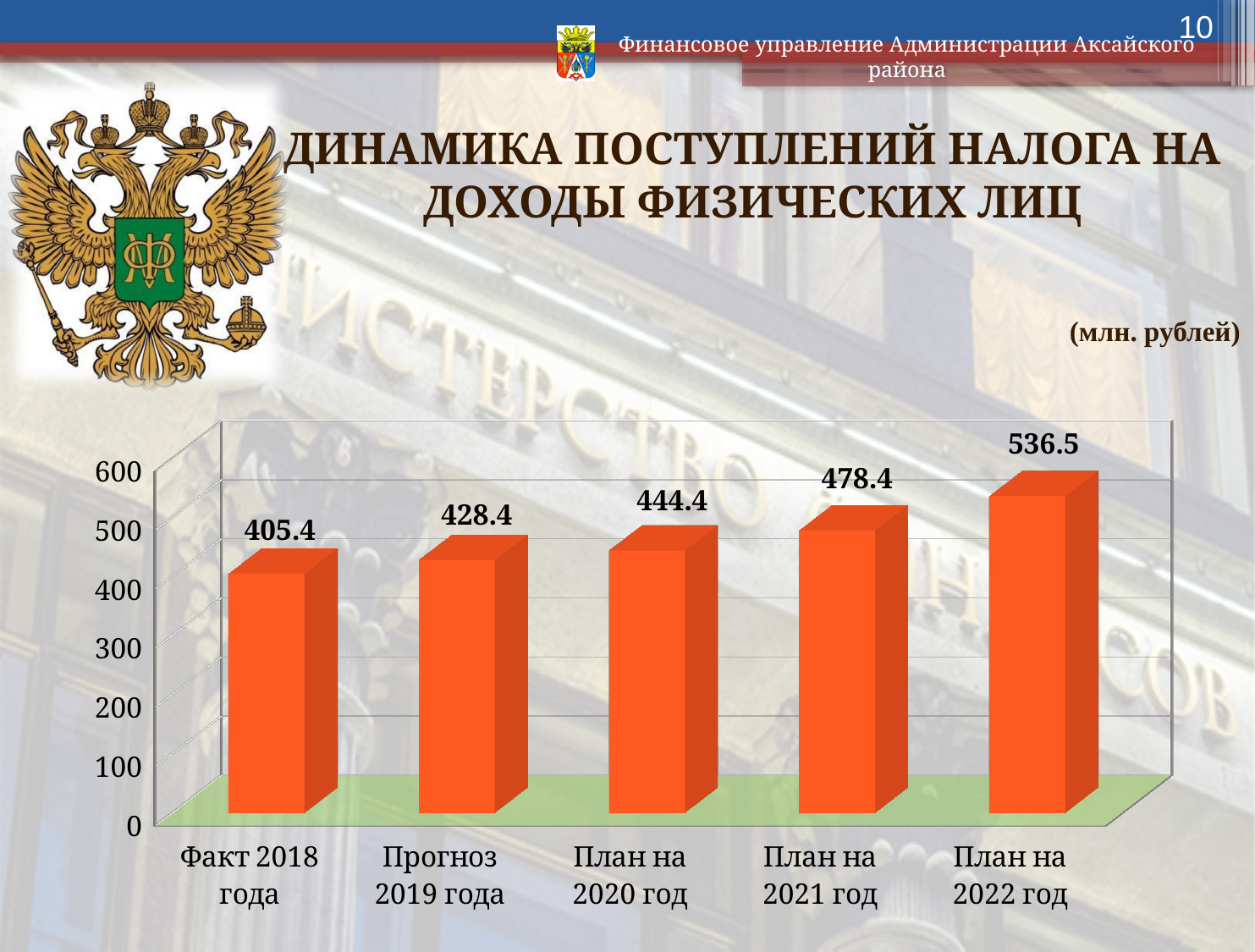
Which category has the highest value? План на 2022 год What is the difference between the values for План на 2022 год and План на 2021 год? 58.1 What is the value for Прогноз 2019 года? 428.4 What kind of chart is shown on the slide? bar chart How many categories are shown on the chart? 5 Which is larger, the value for План на 2021 год or the value for План на 2020 год? План на 2021 год Which category has the lowest value? Факт 2018 года Do the values rise or fall from Факт 2018 года to План на 2022 год? rise Is the value for План на 2022 год greater or less than 500? greater What is the difference between the values for План на 2020 год and Прогноз 2019 года? 16.0 What is the value for План на 2022 год? 536.5 What is the value for Факт 2018 года? 405.4